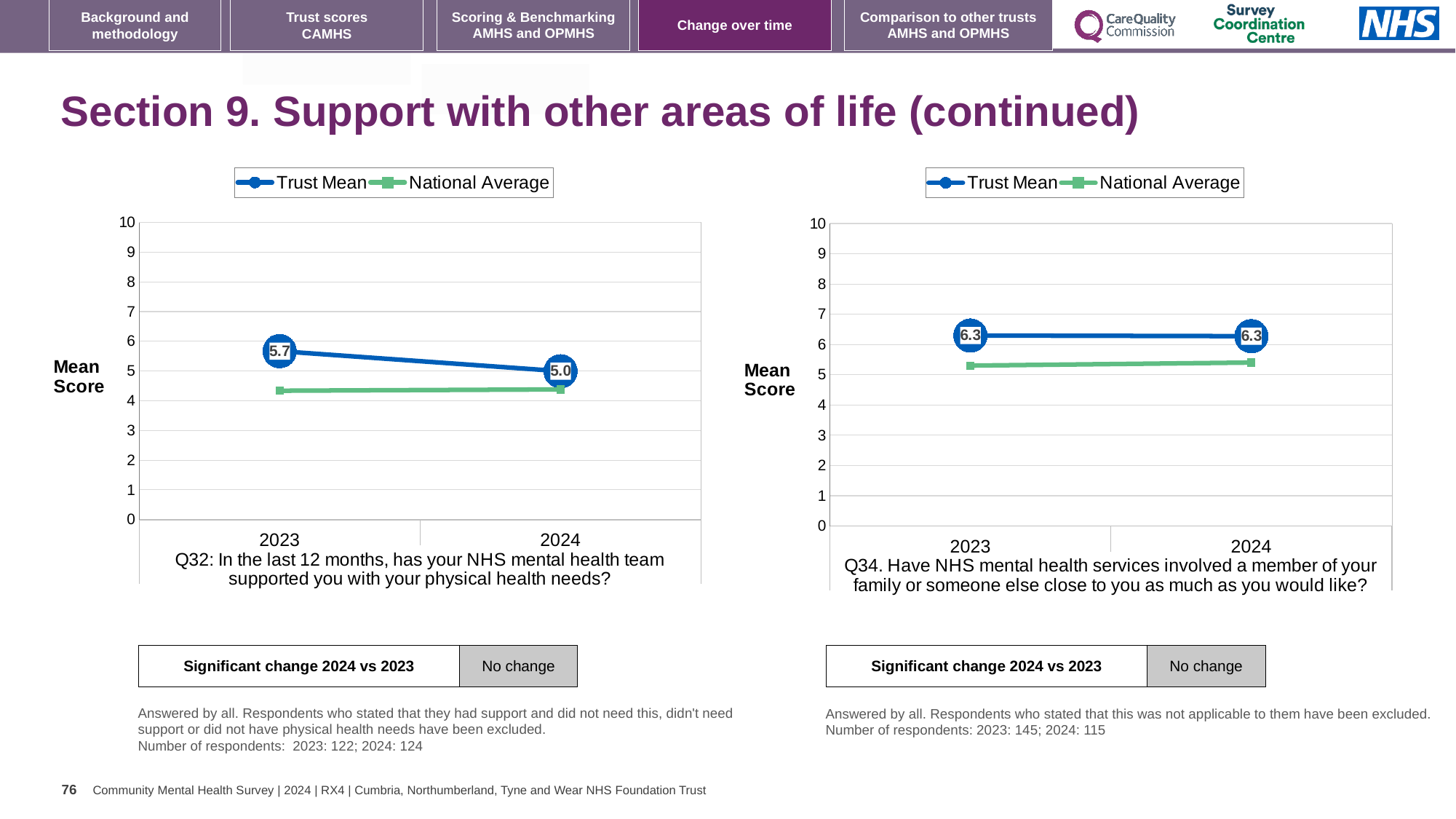
In the left chart (Q32), by how much did the Trust Mean change from 2023 to 2024? 0.7 How many series does the legend of the left chart (Q32) list? 2 In the right chart (Q34), does the Trust Mean rise, fall or stay the same from 2023 to 2024? stay the same In the left chart (Q32), what is the Trust Mean for 2023? 5.7 In the right chart (Q34), which series is higher in 2023, Trust Mean or National Average? Trust Mean What type of chart is the right chart (Q34)? line chart In the left chart (Q32), what is the Trust Mean for 2024? 5.0 In the left chart (Q32), does the Trust Mean rise or fall from 2023 to 2024? fall In the right chart (Q34), what is the Trust Mean for 2024? 6.3 In the right chart (Q34), is the National Average for 2024 greater or less than 6? less In the left chart (Q32), is the National Average for 2023 greater or less than 5? less How many years are plotted on the x axis of the left chart (Q32)? 2